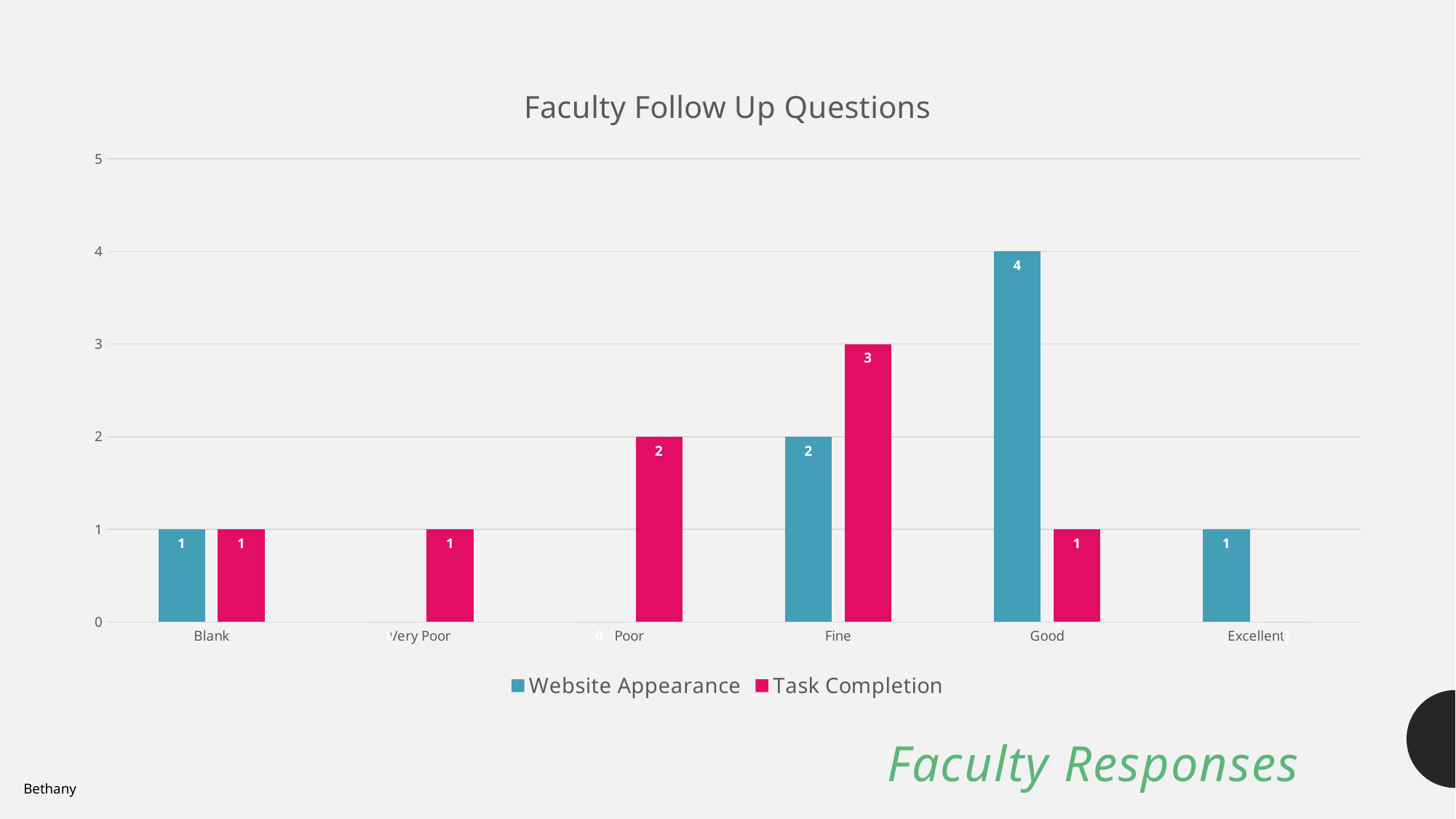
What is the title of the chart? Faculty Follow Up Questions Which category has the highest Website Appearance value? Good How many series does the legend list? 2 What is the value for Website Appearance in the Good category? 4 What kind of chart is shown on the slide? Bar chart What is the value for Task Completion in the Fine category? 3 What is the value for Task Completion in the Poor category? 2 How many categories are shown on the x axis? 6 In the Fine category, which series has the larger value, Website Appearance or Task Completion? Task Completion What is the difference between Website Appearance and Task Completion in the Good category? 3 What is the value for Website Appearance in the Excellent category? 1 Which category has the highest Task Completion value? Fine